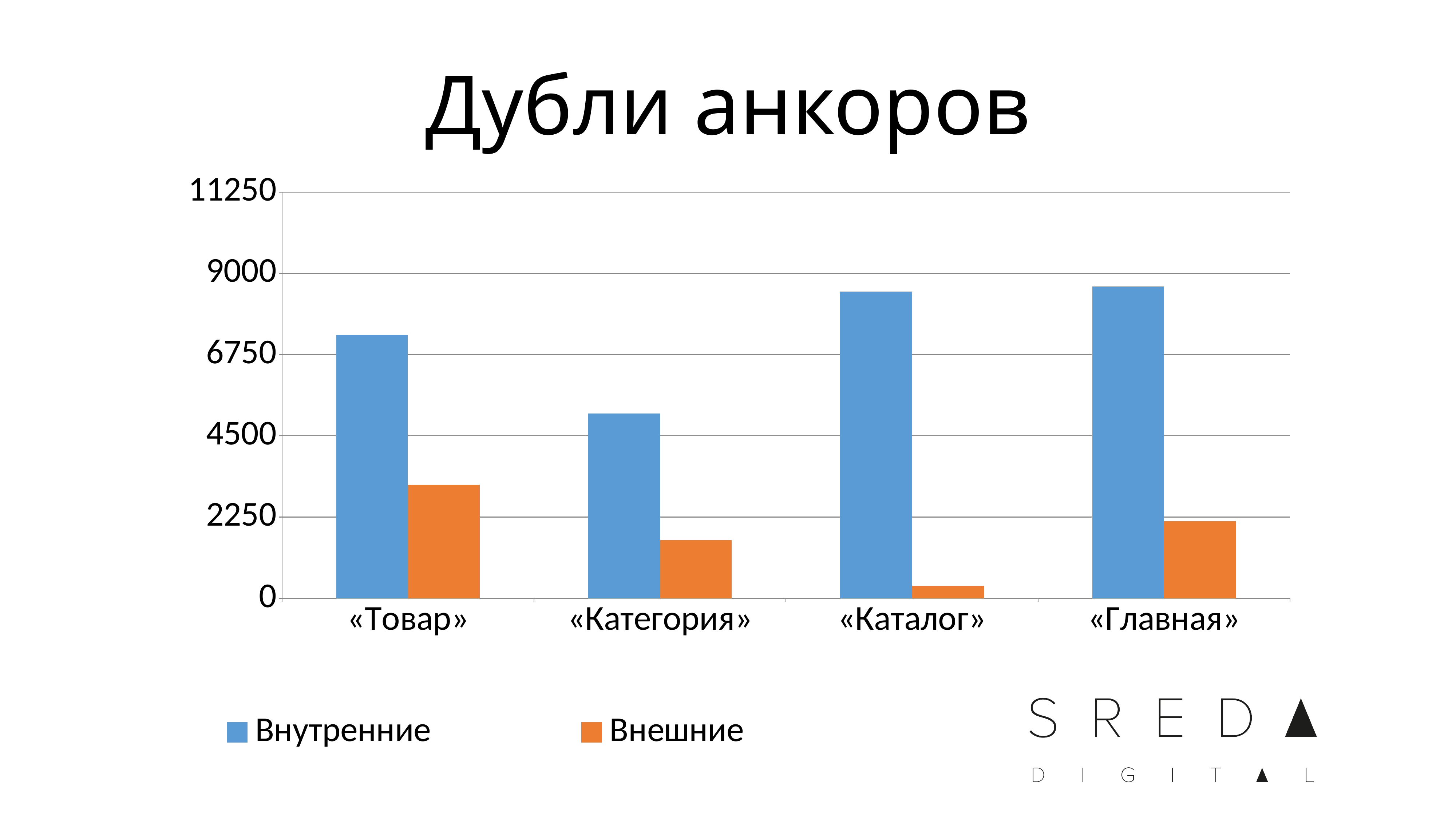
Is the Внешние value for «Каталог» greater or less than 2250? less For «Каталог», which series has the larger value, Внутренние or Внешние? Внутренние What is the title of the chart? Дубли анкоров How many series does the legend list? 2 Is the Внешние value for «Товар» greater or less than 2250? greater How many categories are shown on the x axis? 4 What type of chart is shown on the slide? bar chart Which category has the lowest value for Внешние? «Каталог» Which category has the lowest value for Внутренние? «Категория» Is the Внутренние value for «Товар» greater or less than 6750? greater Which colour represents the Внешние series in the legend? orange Which category has the highest value for Внешние? «Товар»